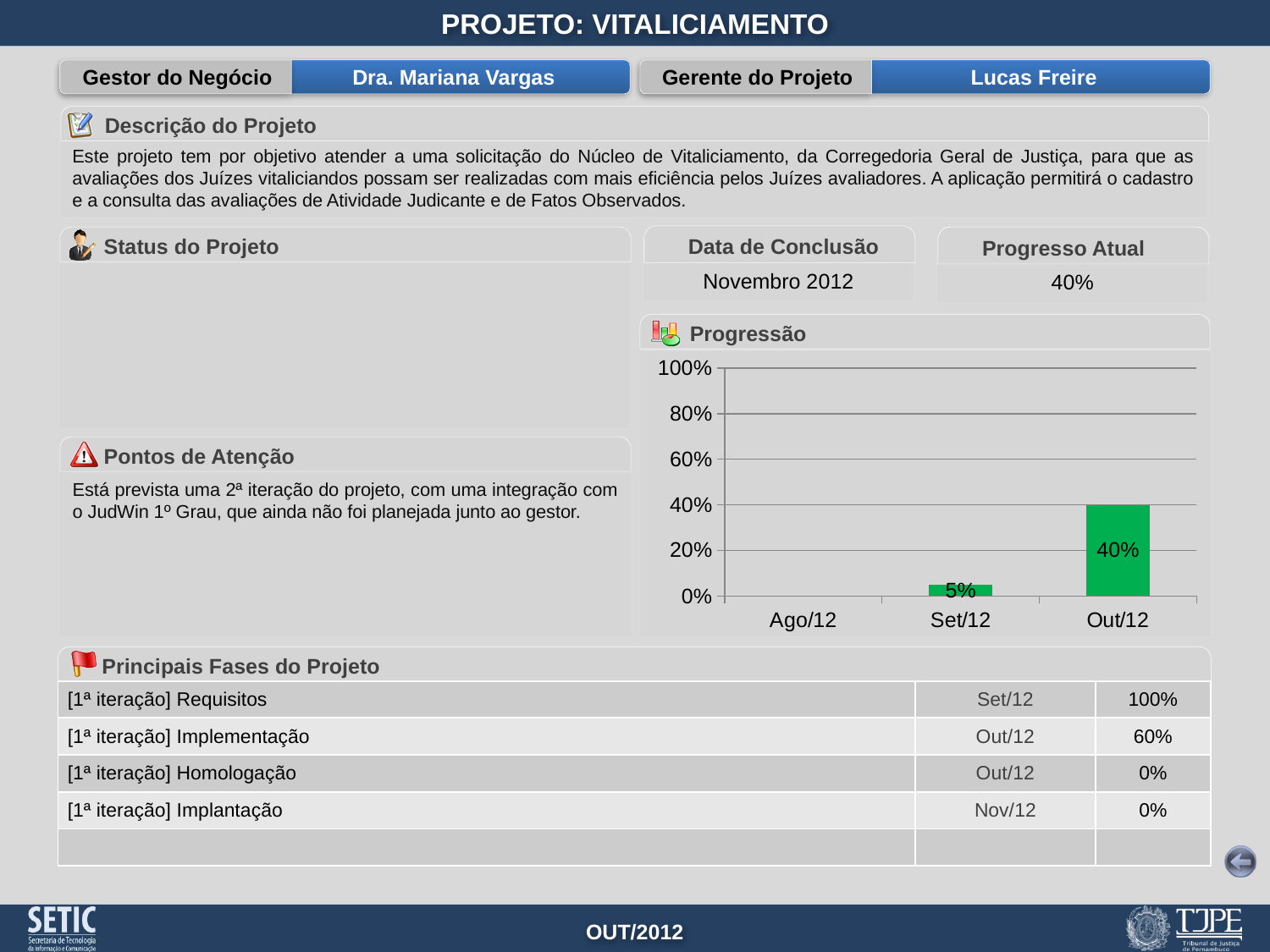
What is the title of the chart on the slide? Progressão In the Progressão chart, which is larger, the value for Set/12 or the value for Out/12? Out/12 In the Progressão chart, is the value for Set/12 greater or less than 20%? less In the Progressão chart, is the value for Out/12 greater or less than 20%? greater In the Progressão chart, which month has the highest value? Out/12 In the Progressão chart, what is the value for Set/12? 5% What colour are the bars in the Progressão chart? green In the Progressão chart, what is the value for Out/12? 40% In the Progressão chart, what is the difference between the values for Out/12 and Set/12? 35% What kind of chart is the Progressão chart? bar chart In the Progressão chart, do the values rise or fall from Ago/12 to Out/12? rise How many months are shown on the x axis of the Progressão chart? 3